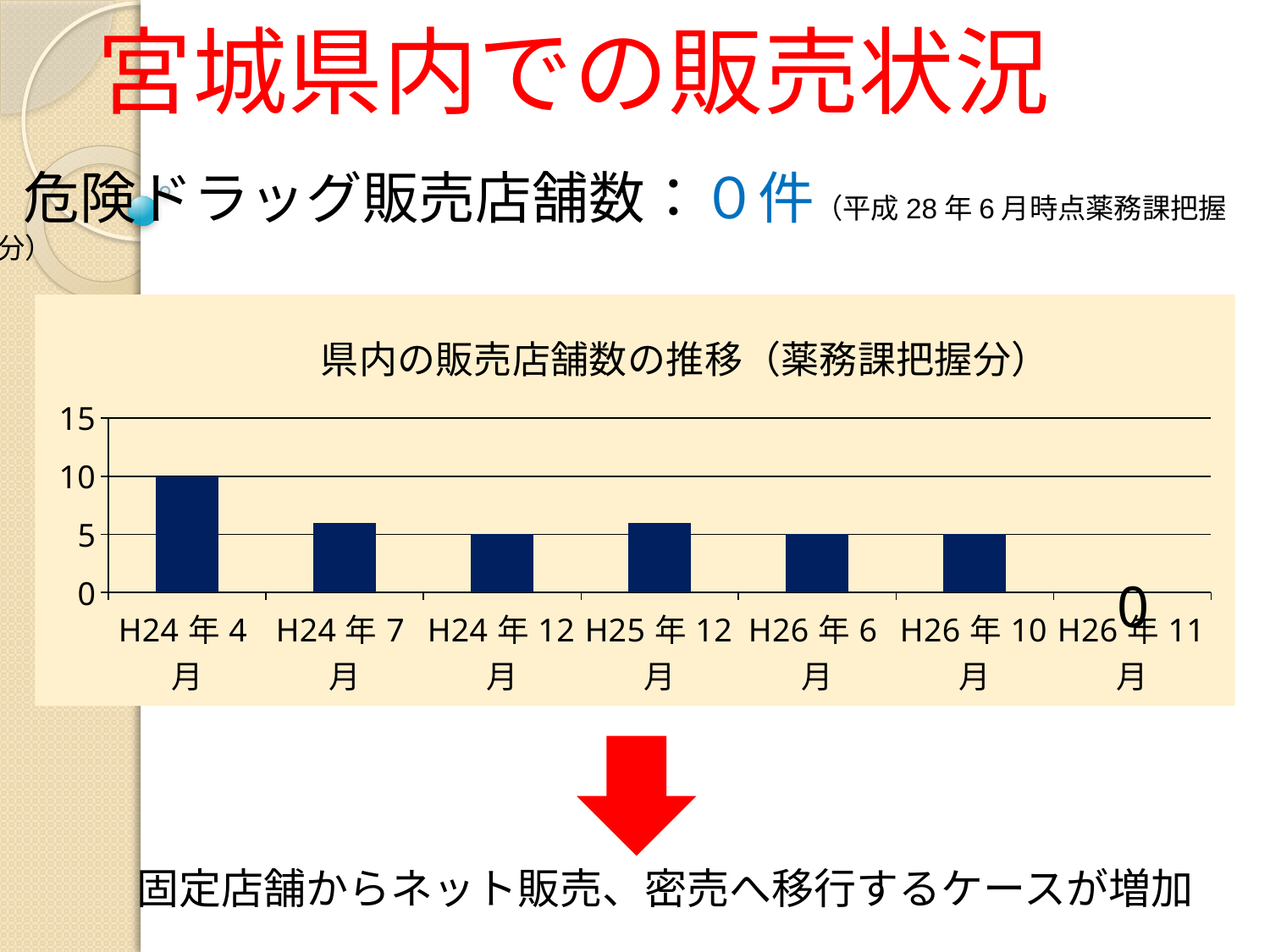
What is the difference between the values for H24年4月 and H26年10月? 5 Is the value for H25年12月 greater or less than 5? greater Which period has the highest number of stores in the chart? H24年4月 Which period has the lowest number of stores in the chart? H26年11月 What is the value for H26年11月? 0 What is the value for H24年4月? 10 What is the title of the chart? 県内の販売店舗数の推移（薬務課把握分） How many time periods are shown on the x axis of the chart? 7 What kind of chart is shown on the slide? bar chart Is the value for H24年7月 greater or less than 10? less Which is larger, the value for H24年4月 or the value for H26年6月? H24年4月 What is the value for H26年10月? 5